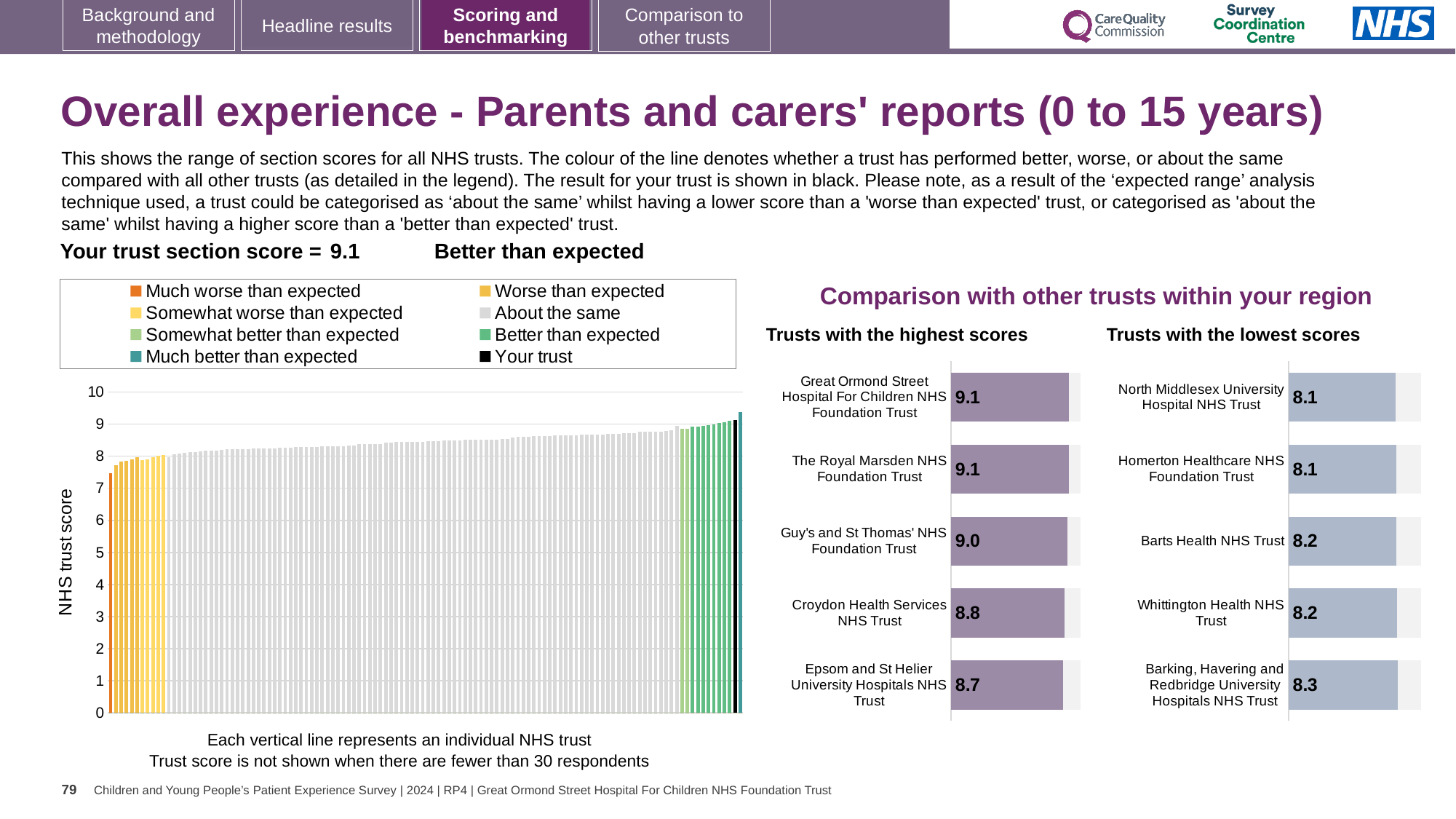
In the 'Trusts with the lowest scores' chart, which trust has the highest score? Barking, Havering and Redbridge University Hospitals NHS Trust What kind of chart is the large 'NHS trust score' chart on the left of the slide? Bar chart How many trusts are shown in the 'Trusts with the highest scores' chart? 5 In the 'Trusts with the lowest scores' chart, what is the score for Barts Health NHS Trust? 8.2 What is the section score for your trust shown above the 'NHS trust score' chart? 9.1 How many entries does the legend of the 'NHS trust score' chart list? 8 In the 'Trusts with the highest scores' chart, what is the score for Croydon Health Services NHS Trust? 8.8 In the 'Trusts with the highest scores' chart, what is the difference between the scores of Great Ormond Street Hospital For Children NHS Foundation Trust and Epsom and St Helier University Hospitals NHS Trust? 0.4 In the 'NHS trust score' chart, is the value of the orange 'Much worse than expected' bar greater or less than 8? less In the 'Trusts with the highest scores' chart, which has the larger score: Guy's and St Thomas' NHS Foundation Trust or Croydon Health Services NHS Trust? Guy's and St Thomas' NHS Foundation Trust In the 'Trusts with the highest scores' chart, which trust has the lowest score? Epsom and St Helier University Hospitals NHS Trust What is the title of the section containing the two small bar charts on the right of the slide? Comparison with other trusts within your region